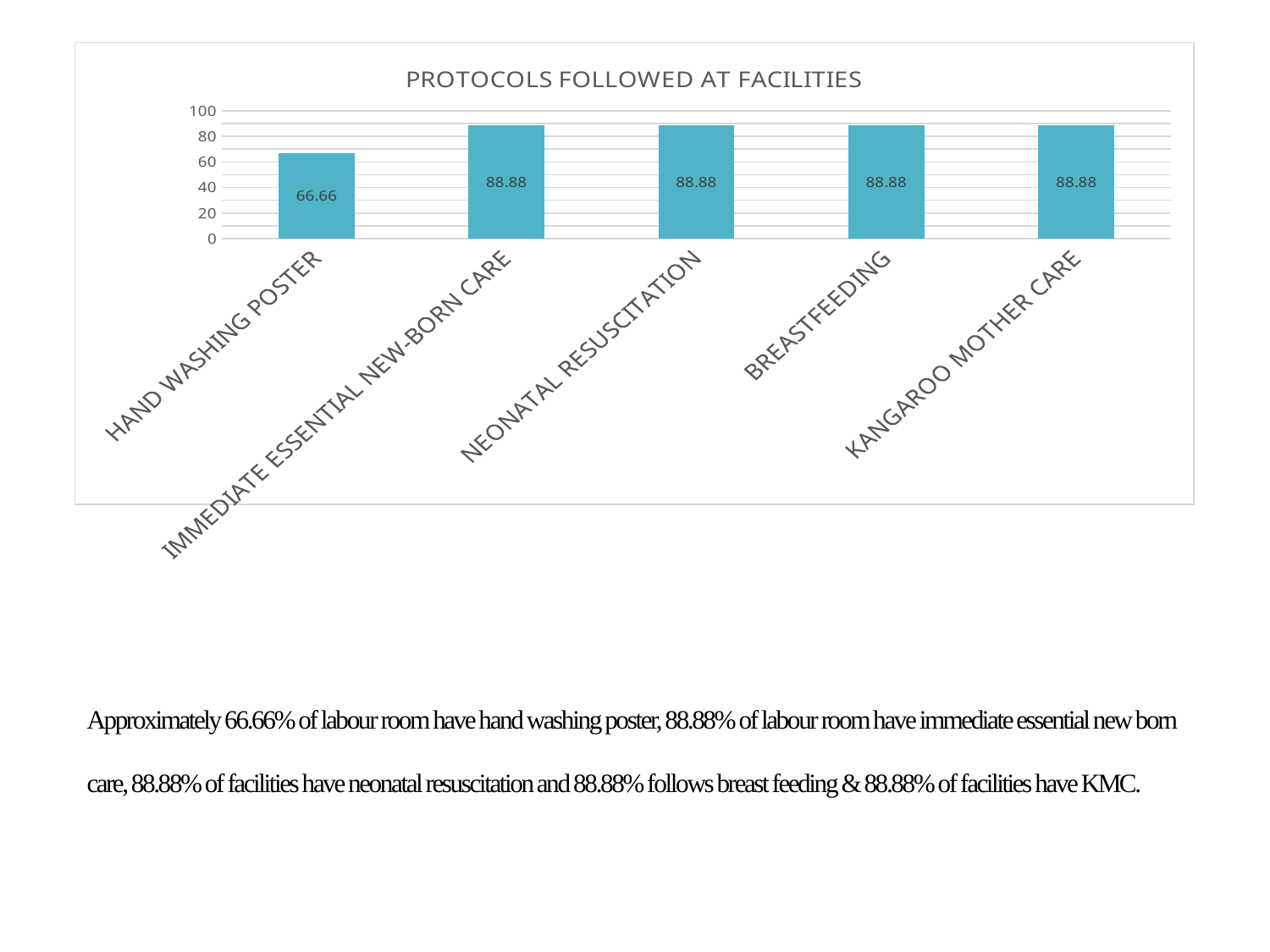
How many categories share the value 88.88? 4 Is the value for HAND WASHING POSTER greater or less than 80? less Is the value for BREASTFEEDING greater or less than 80? greater Which category has the lowest value? HAND WASHING POSTER What is the difference between the values for BREASTFEEDING and HAND WASHING POSTER? 22.22 How many categories are shown on the chart? 5 What is the title of the chart? PROTOCOLS FOLLOWED AT FACILITIES Which is larger, the value for IMMEDIATE ESSENTIAL NEW-BORN CARE or the value for HAND WASHING POSTER? IMMEDIATE ESSENTIAL NEW-BORN CARE What is the value for HAND WASHING POSTER? 66.66 What kind of chart is shown on the slide? Bar chart What is the value for KANGAROO MOTHER CARE? 88.88 What is the value for NEONATAL RESUSCITATION? 88.88